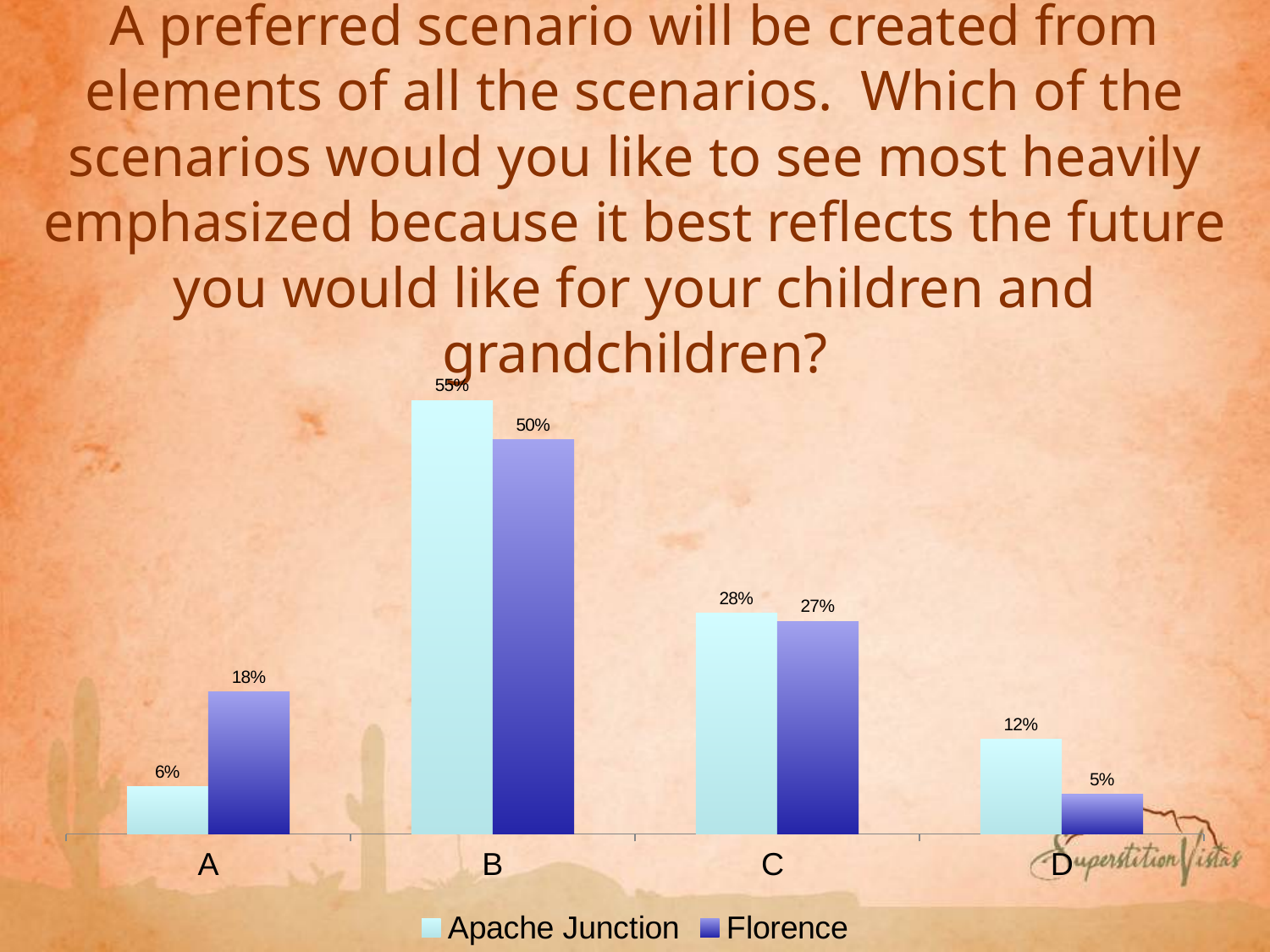
Which is larger for scenario D, the Apache Junction value or the Florence value? Apache Junction What is the value for Apache Junction for scenario B? 55% What kind of chart is shown on the slide? Bar chart Which scenario has the highest value for Florence? B What is the value for Florence for scenario A? 18% Which scenario has the lowest value for Apache Junction? A How many series does the legend list? 2 What is the difference between the Apache Junction and Florence values for scenario B? 5% What is the value for Florence for scenario D? 5% How many scenarios are shown on the x axis? 4 What is the difference between the Apache Junction and Florence values for scenario A? 12% What is the value for Apache Junction for scenario C? 28%